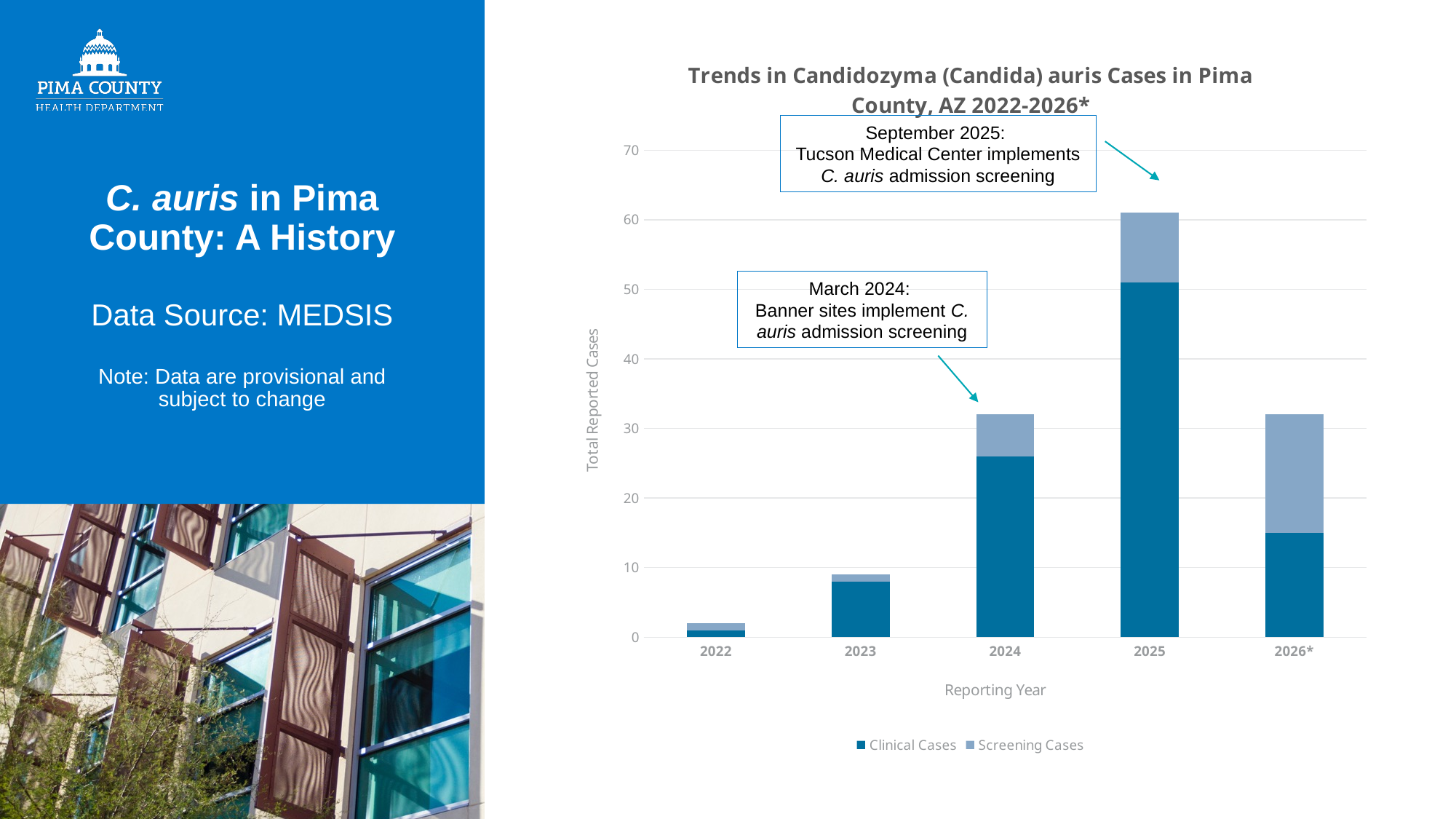
What are the two series named in the chart's legend? Clinical Cases and Screening Cases How many series does the chart's legend list? 2 Is the total reported cases for 2025 greater or less than 50? greater Is the number of Clinical Cases for 2026* greater or less than 20? less Which has more total reported cases, 2024 or 2025? 2025 Which reporting year has the lowest total reported cases? 2022 Is the total reported cases for 2022 greater or less than 10? less What kind of chart is shown on the slide? bar chart Which reporting year has the highest total reported cases? 2025 How many reporting years are shown on the x axis of the chart? 5 Do total reported cases rise or fall from 2022 to 2025? rise